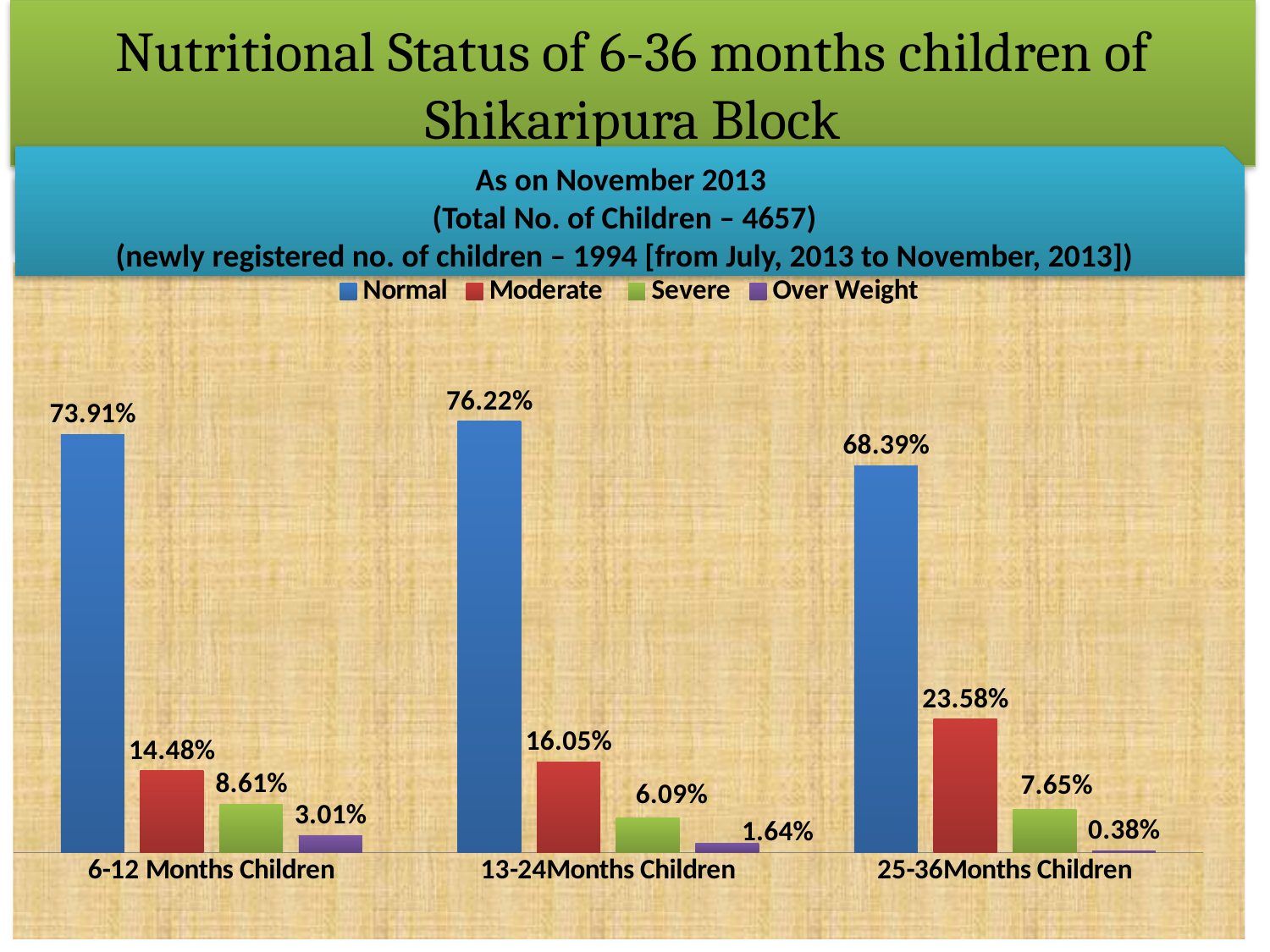
How many series does the legend list? 4 What is the difference between the Moderate values for 25-36Months Children and 6-12 Months Children? 9.10% What is the difference between the Normal values for 13-24Months Children and 6-12 Months Children? 2.31% How many age group categories are shown on the x axis? 3 What kind of chart is shown on the slide? Bar chart Which is larger, the Severe value for 6-12 Months Children or the Severe value for 13-24Months Children? 6-12 Months Children Which age group has the lowest Over Weight value? 25-36Months Children What is the Normal value for 6-12 Months Children? 73.91% What is the Severe value for 25-36Months Children? 7.65% What is the Moderate value for 25-36Months Children? 23.58% Which age group has the highest Normal value? 13-24Months Children What is the Over Weight value for 13-24Months Children? 1.64%